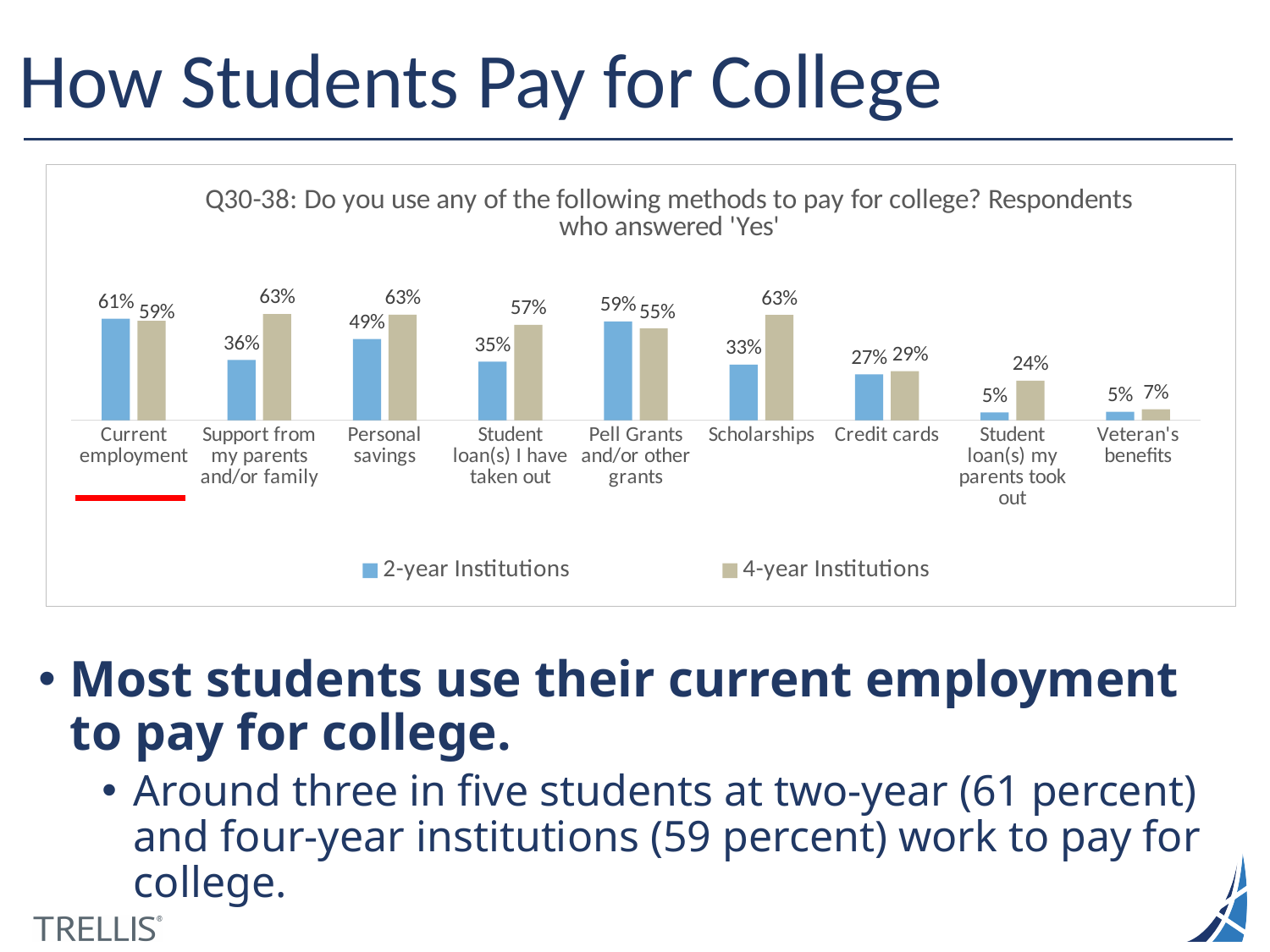
How many payment method categories are shown on the x axis? 9 Which category has the highest value for 2-year institutions? Current employment Which series is shown in blue in the legend? 2-year Institutions What percentage of respondents at 2-year institutions use current employment to pay for college? 61% For Pell Grants and/or other grants, which is larger: the 2-year or the 4-year institutions value? 2-year Institutions What kind of chart is shown on the slide? Bar chart What percentage of respondents at 4-year institutions use scholarships to pay for college? 63% Which category has the lowest value for 4-year institutions? Veteran's benefits How many series does the legend list? 2 What is the difference between the 4-year and 2-year institution values for 'Support from my parents and/or family'? 27% What is the difference between the 2-year and 4-year institution values for Personal savings? 14% What is the value for 'Student loan(s) my parents took out' for 2-year institutions? 5%